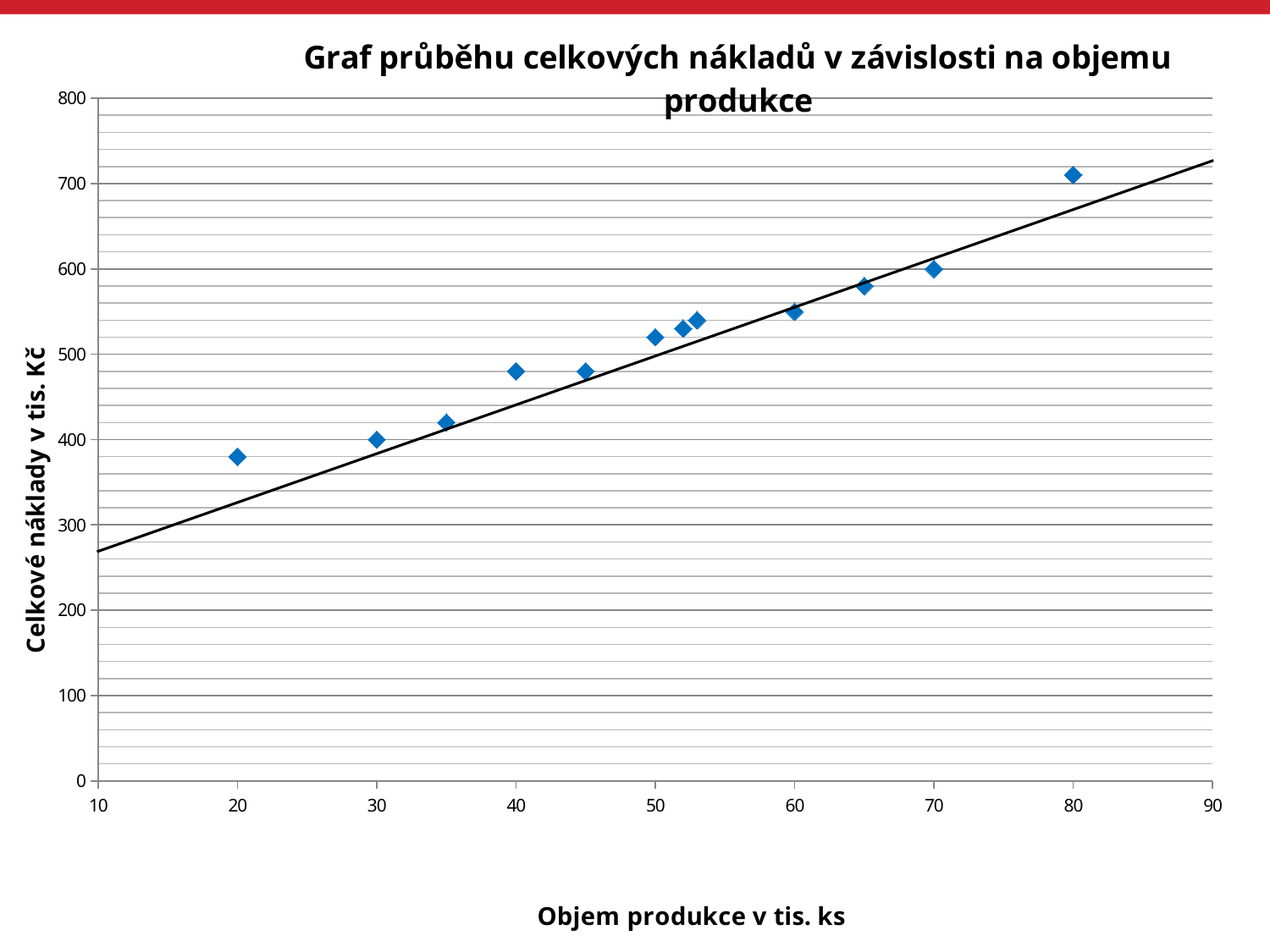
What is the title of the chart? Graf průběhu celkových nákladů v závislosti na objemu produkce How many data points are plotted on the chart? 12 At which production volume (x value) is the plotted total cost lowest? 20 Is the total cost at a production volume of 60 greater or less than 500? greater Do the total costs rise or fall as production volume increases along the x axis? rise Is the total cost at a production volume of 30 greater or less than 500? less Which has the higher total cost: the point at production volume 70 or the point at production volume 40? 70 What kind of chart is shown on the slide? scatter chart Is the total cost at a production volume of 80 greater or less than 700? greater At which production volume (x value) is the plotted total cost highest? 80 What is the label of the vertical axis? Celkové náklady v tis. Kč